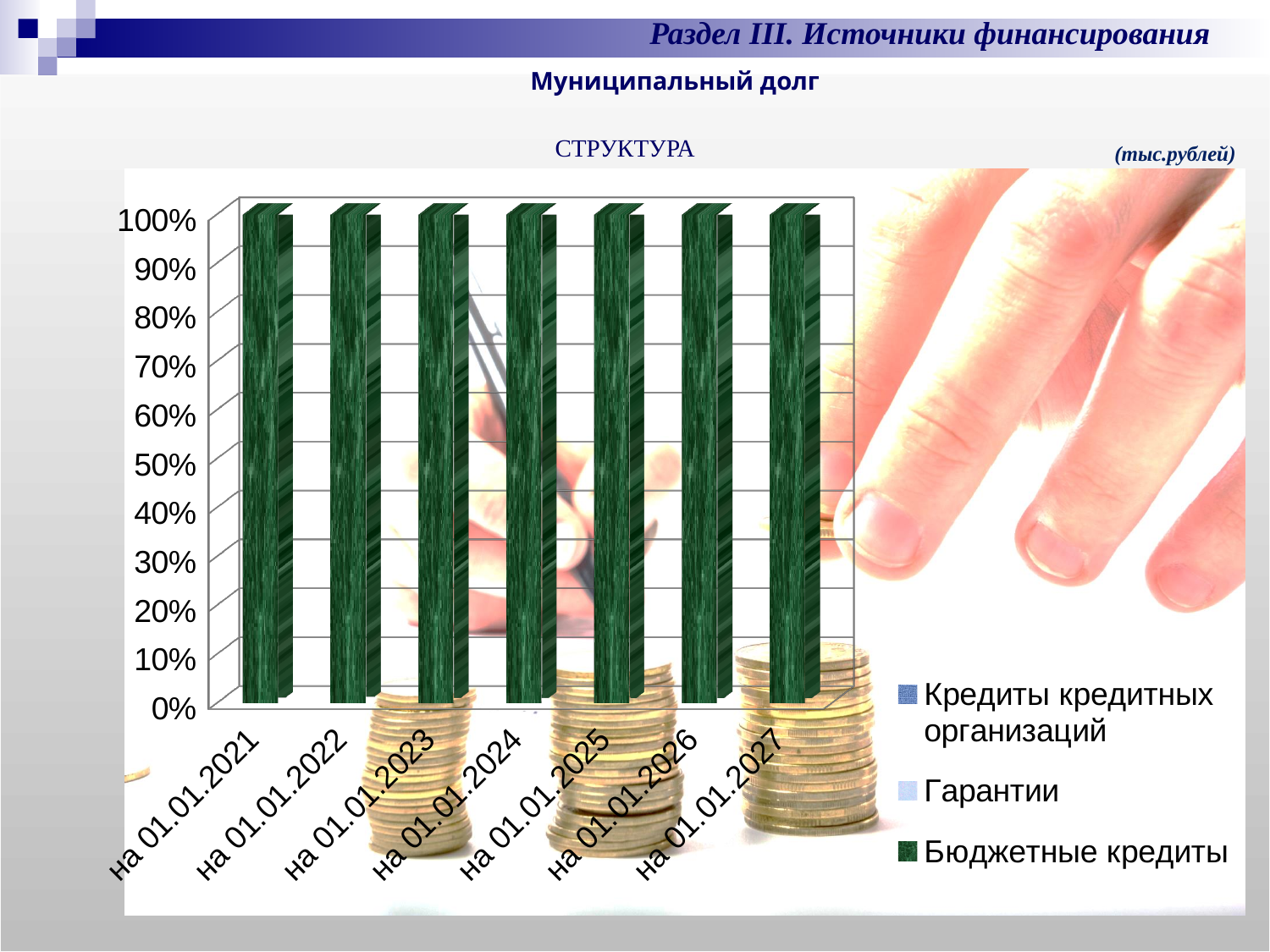
What kind of chart is shown on the slide? bar chart What is the first category label on the x axis? на 01.01.2021 What is the highest tick value shown on the y axis? 100% What share of the bar for на 01.01.2021 is taken by Бюджетные кредиты? 100% Is the value for Бюджетные кредиты at на 01.01.2024 greater or less than 50%? greater How many dates (categories) are shown along the x axis of the chart? 7 What is the last category label on the x axis? на 01.01.2027 What is the title shown above the chart? СТРУКТУРА Which legend entry is shown in dark green? Бюджетные кредиты What share of the bar for на 01.01.2027 is taken by Бюджетные кредиты? 100% Does the share of Бюджетные кредиты rise, fall or stay the same from на 01.01.2021 to на 01.01.2027? stays the same How many series does the chart legend list? 3